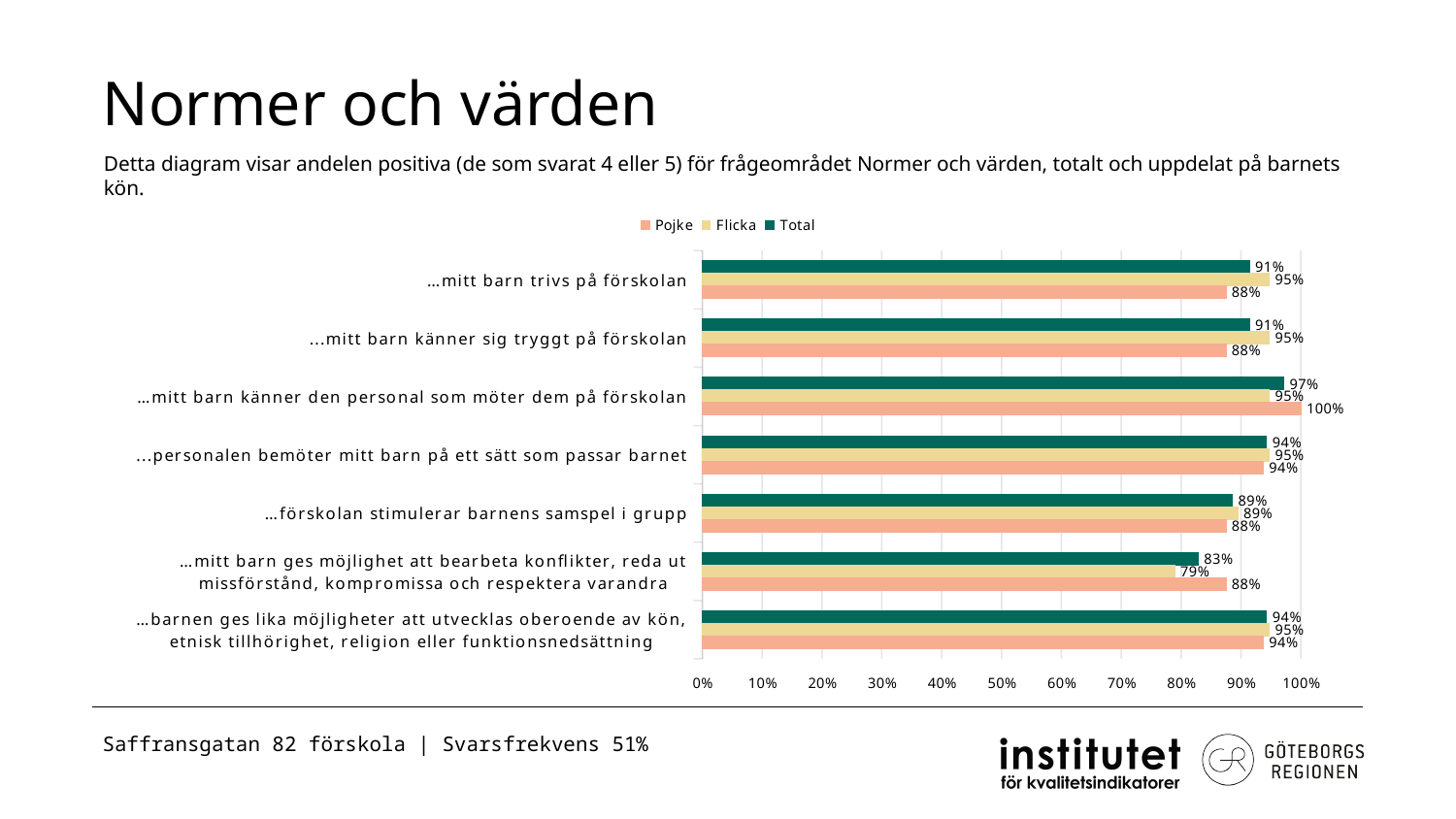
What is the Flicka value for "…förskolan stimulerar barnens samspel i grupp"? 89% What is the Total value for "…mitt barn känner den personal som möter dem på förskolan"? 97% What is the difference between the Pojke and Flicka values for "…mitt barn känner den personal som möter dem på förskolan"? 5% What is the difference between the Flicka and Pojke values for "…mitt barn trivs på förskolan"? 7% What is the Pojke value for "…mitt barn ges möjlighet att bearbeta konflikter, reda ut missförstånd, kompromissa och respektera varandra"? 88% Which category has the lowest Total value? …mitt barn ges möjlighet att bearbeta konflikter, reda ut missförstånd, kompromissa och respektera varandra How many categories (statements) are plotted on the chart? 7 Which category has the highest Pojke value? …mitt barn känner den personal som möter dem på förskolan How many series does the legend list? 3 For "…mitt barn ges möjlighet att bearbeta konflikter, reda ut missförstånd, kompromissa och respektera varandra", which is larger: the Pojke value or the Flicka value? Pojke What kind of chart is shown on the slide? bar chart Which series in the legend is shown in dark green? Total